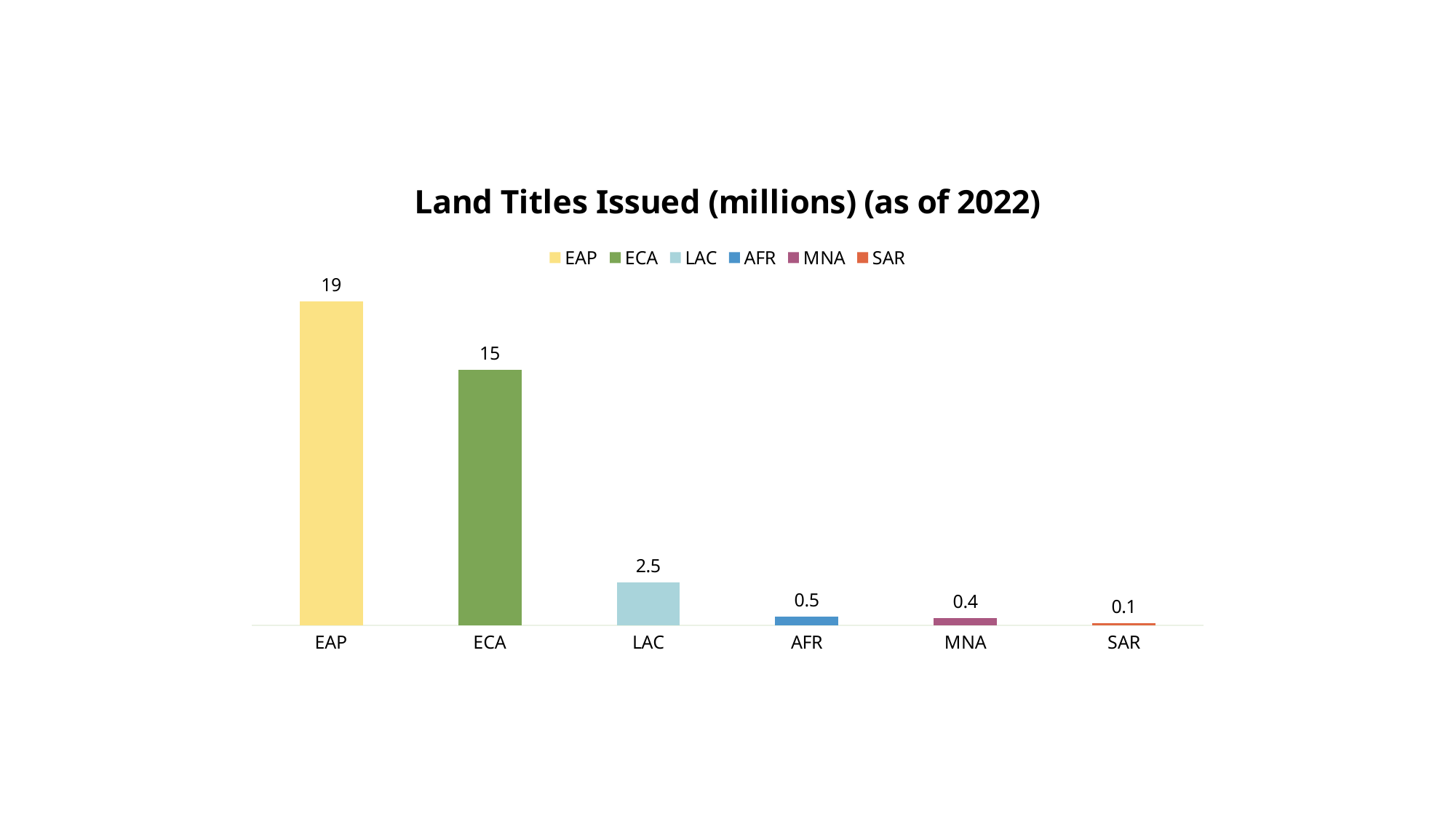
How many regions are shown on the x axis? 6 What kind of chart is shown on the slide? Bar chart What is the title of the chart? Land Titles Issued (millions) (as of 2022) What is the difference between the values for EAP and ECA? 4 What is the value for EAP? 19 Which region has the lowest number of land titles issued? SAR How many entries does the legend list? 6 What is the value for LAC? 2.5 What is the value for MNA? 0.4 Which is larger, the value for ECA or the value for LAC? ECA What is the difference between the values for LAC and AFR? 2 Which region has the highest number of land titles issued? EAP